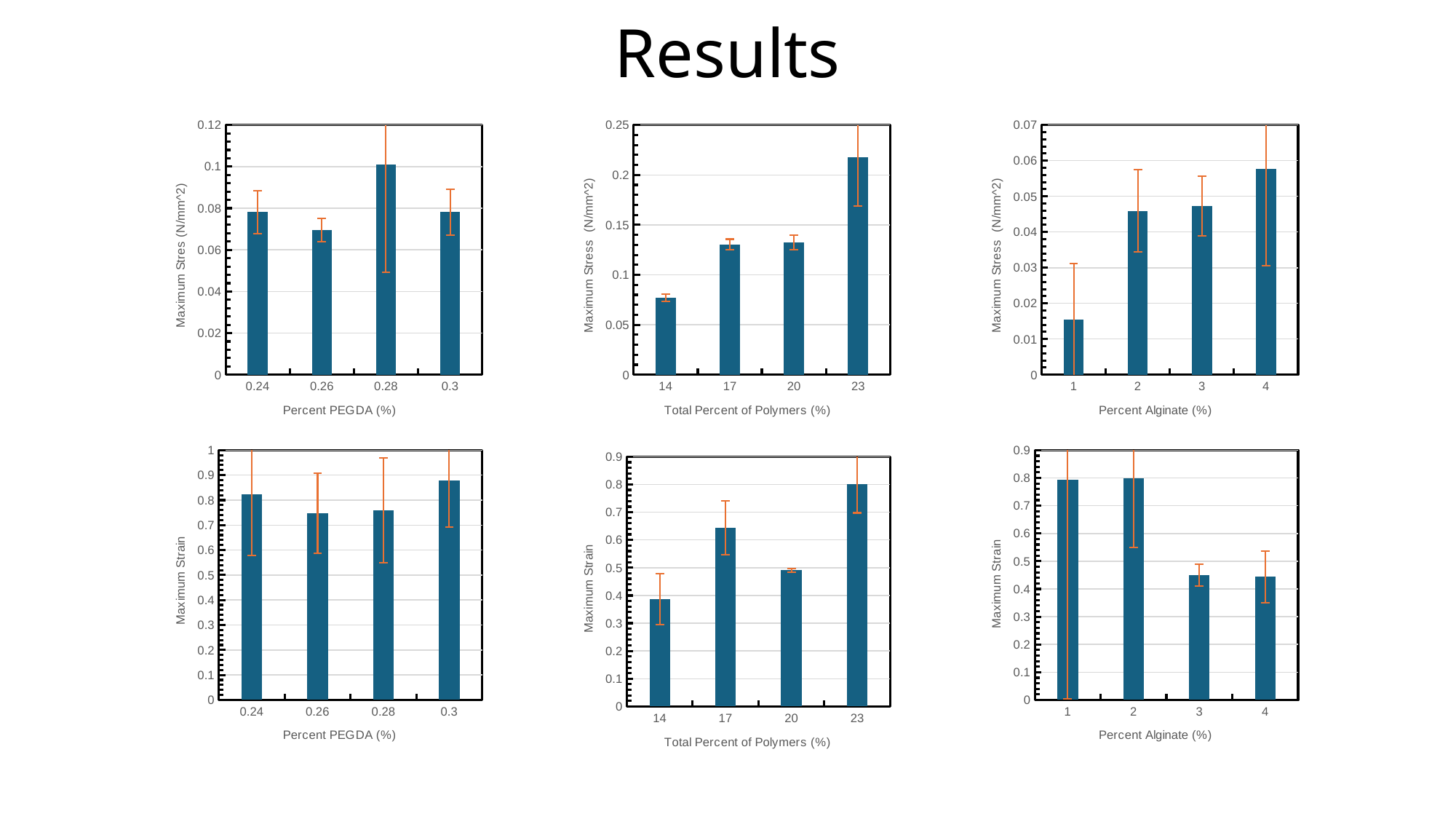
In the bottom-middle chart (Maximum Strain vs Total Percent of Polymers), which is larger, the value for 17 or the value for 20? 17 In the top-middle chart (Maximum Stress vs Total Percent of Polymers), do the values rise or fall as Total Percent of Polymers increases? rise In the bottom-left chart (Maximum Strain vs Percent PEGDA), which Percent PEGDA category has the highest maximum strain? 0.3 In the top-middle chart (Maximum Stress vs Total Percent of Polymers), which category has the highest maximum stress? 23 In the bottom-right chart (Maximum Strain vs Percent Alginate), is the value for 3 greater or less than 0.5? less In the top-left chart (Maximum Stress vs Percent PEGDA), is the value for 0.28 greater or less than 0.08? greater In the top-right chart (Maximum Stress vs Percent Alginate), which Percent Alginate category has the lowest maximum stress? 1 What kind of chart is the top-middle chart (Maximum Stress vs Total Percent of Polymers)? bar chart How many categories are shown on the x axis of the bottom-right chart (Maximum Strain vs Percent Alginate)? 4 In the top-left chart (Maximum Stress vs Percent PEGDA), which Percent PEGDA category has the highest maximum stress? 0.28 In the top-middle chart (Maximum Stress vs Total Percent of Polymers), which category has the lowest maximum stress? 14 In the top-right chart (Maximum Stress vs Percent Alginate), is the value for 1 greater or less than 0.02? less